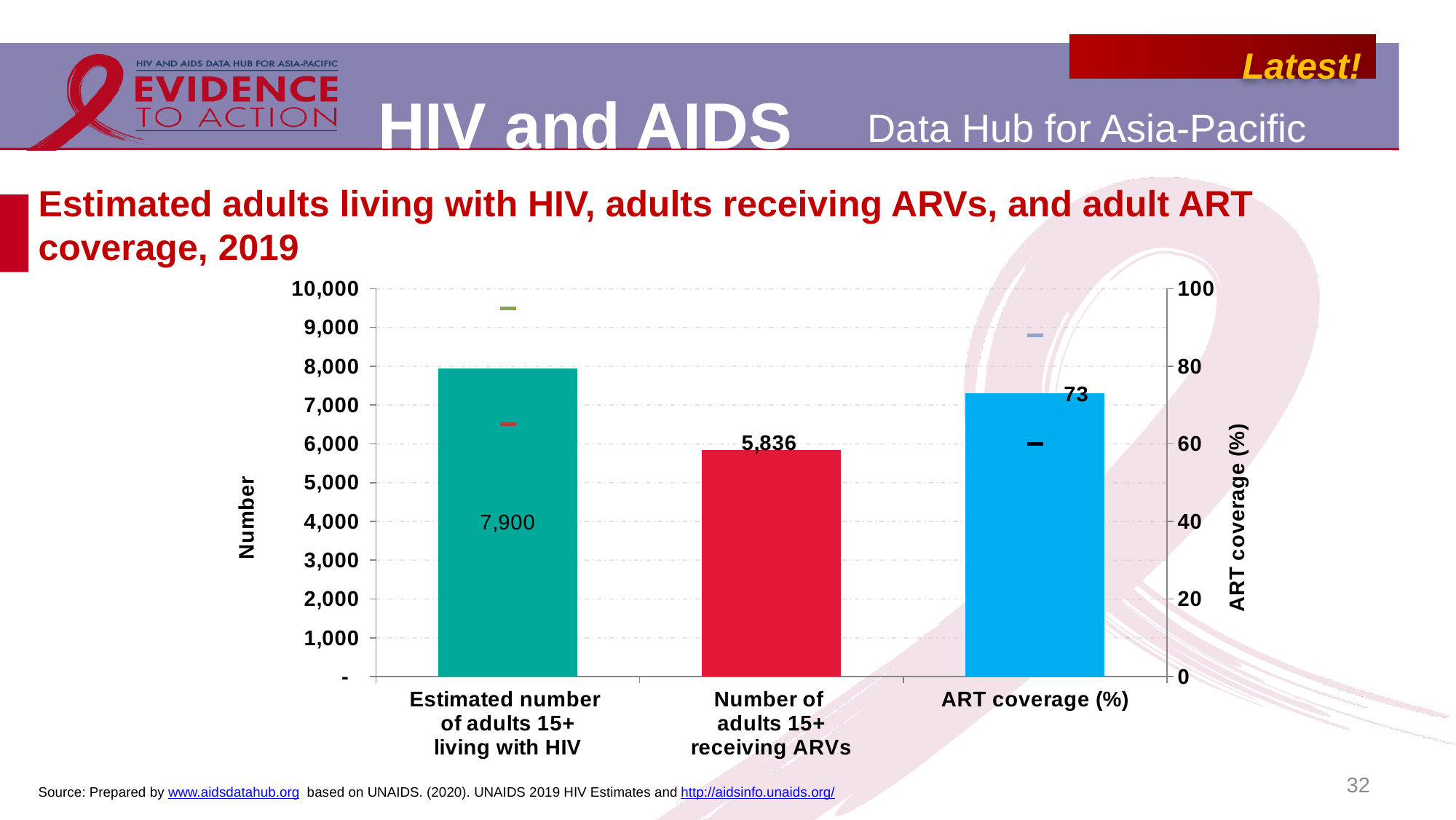
Which is larger: the estimated number of adults 15+ living with HIV or the number of adults 15+ receiving ARVs? Estimated number of adults 15+ living with HIV How many bars are plotted on the chart? 3 Is the number of adults 15+ receiving ARVs greater or less than 6,000? less What is the estimated number of adults 15+ living with HIV shown on the chart? 7,900 Is the ART coverage (%) value greater or less than 60 on the right-hand axis? greater What is the ART coverage (%) value shown on the chart? 73 What is the label of the left-hand vertical axis? Number What is the maximum value shown on the right-hand axis of the chart? 100 What is the label of the right-hand vertical axis? ART coverage (%) What is the difference between the estimated number of adults 15+ living with HIV and the number of adults 15+ receiving ARVs? 2,064 What kind of chart is shown on the slide? Bar chart What is the number of adults 15+ receiving ARVs shown on the chart? 5,836